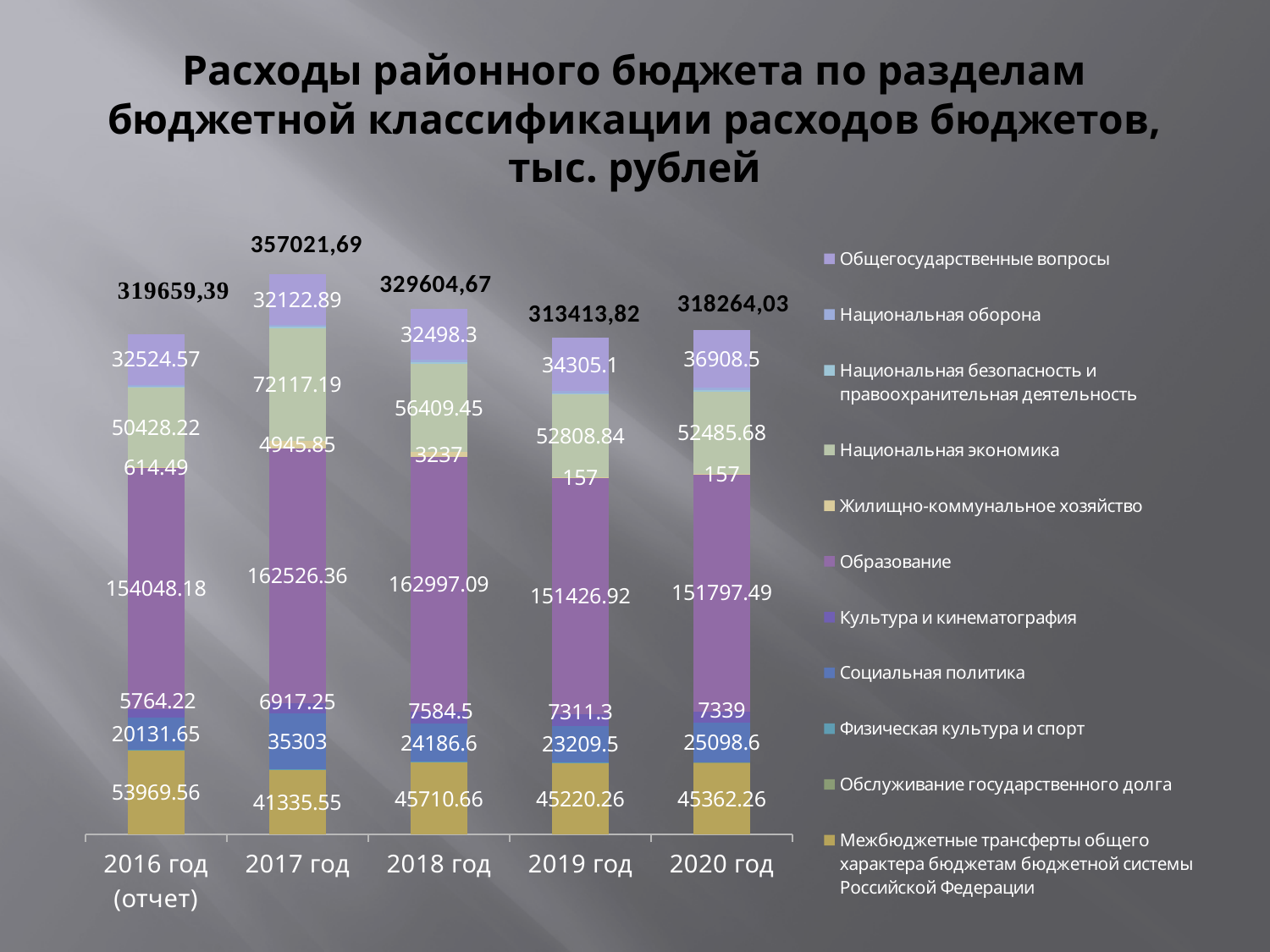
How many series does the legend list? 11 Which year has the lowest total expenditure? 2019 год What is the value of the bottom (gold) segment of the bar for 2016 год (отчет)? 53969.56 How many years (categories) are shown along the x axis? 5 What is the total printed above the bar for 2017 год? 357021,69 In what units are the values on the chart expressed, according to the title? тыс. рублей What kind of chart is shown on the slide? stacked bar chart What is the value of the top segment of the bar for 2020 год? 36908.5 What is the difference between the total for 2017 год and the total for 2016 год (отчет)? 37362,3 Which is larger, the Образование segment in 2017 год or in 2019 год? 2017 год What is the value of the Образование segment for 2018 год? 162997.09 Which year has the highest total expenditure? 2017 год